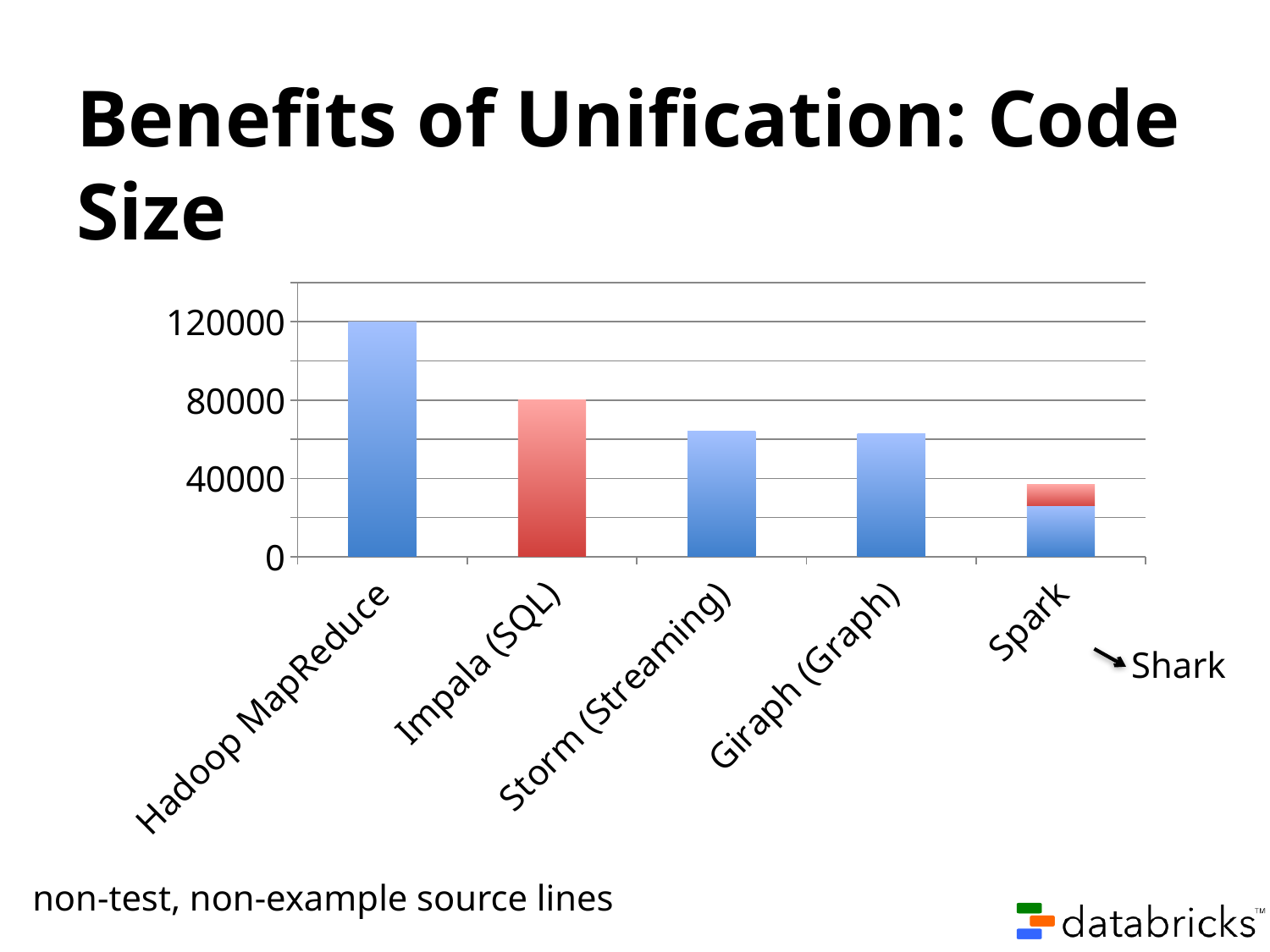
Which is larger, the value for Impala (SQL) or the value for Giraph (Graph)? Impala (SQL) What is the value for Impala (SQL)? 80000 What is the difference between the values for Hadoop MapReduce and Impala (SQL)? 40000 What is the value for Hadoop MapReduce? 120000 How many categories are shown on the x axis of the chart? 5 Is the total value of the Spark bar greater or less than 40000? less What kind of chart is shown on the slide? bar chart What does the red segment on top of the Spark bar represent? Shark According to the note below the chart, what do the values measure? non-test, non-example source lines Which category has the lowest value in the chart? Spark Is the value for Storm (Streaming) greater or less than 40000? greater Which category has the highest value in the chart? Hadoop MapReduce